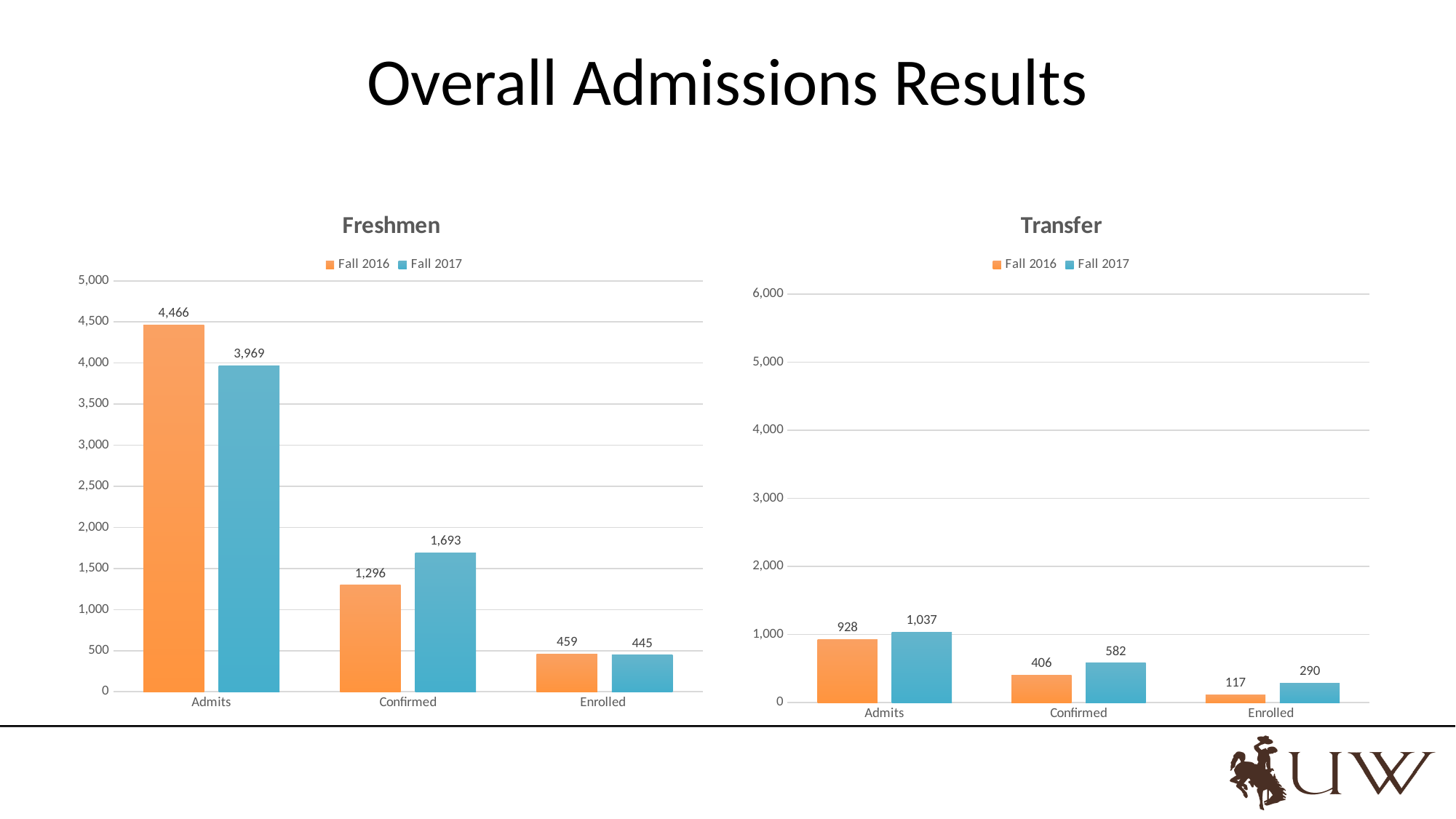
How many categories are shown on the x axis of the Freshmen chart? 3 What kind of chart is the Transfer chart? Bar chart In the Transfer chart, what is the Fall 2017 value for Admits? 1,037 In the Freshmen chart, which is larger for Enrolled: Fall 2016 or Fall 2017? Fall 2016 In the Freshmen chart, which category has the highest Fall 2017 value? Admits In the Freshmen chart, what is the difference between the Fall 2016 and Fall 2017 values for Admits? 497 How many series does the legend of the Transfer chart list? 2 In the Freshmen chart, what is the Fall 2017 value for Confirmed? 1,693 In the Transfer chart, what is the Fall 2016 value for Enrolled? 117 In the Transfer chart, which category has the lowest Fall 2016 value? Enrolled In the Freshmen chart, what is the Fall 2016 value for Admits? 4,466 In the Transfer chart, what is the difference between the Fall 2017 and Fall 2016 values for Confirmed? 176